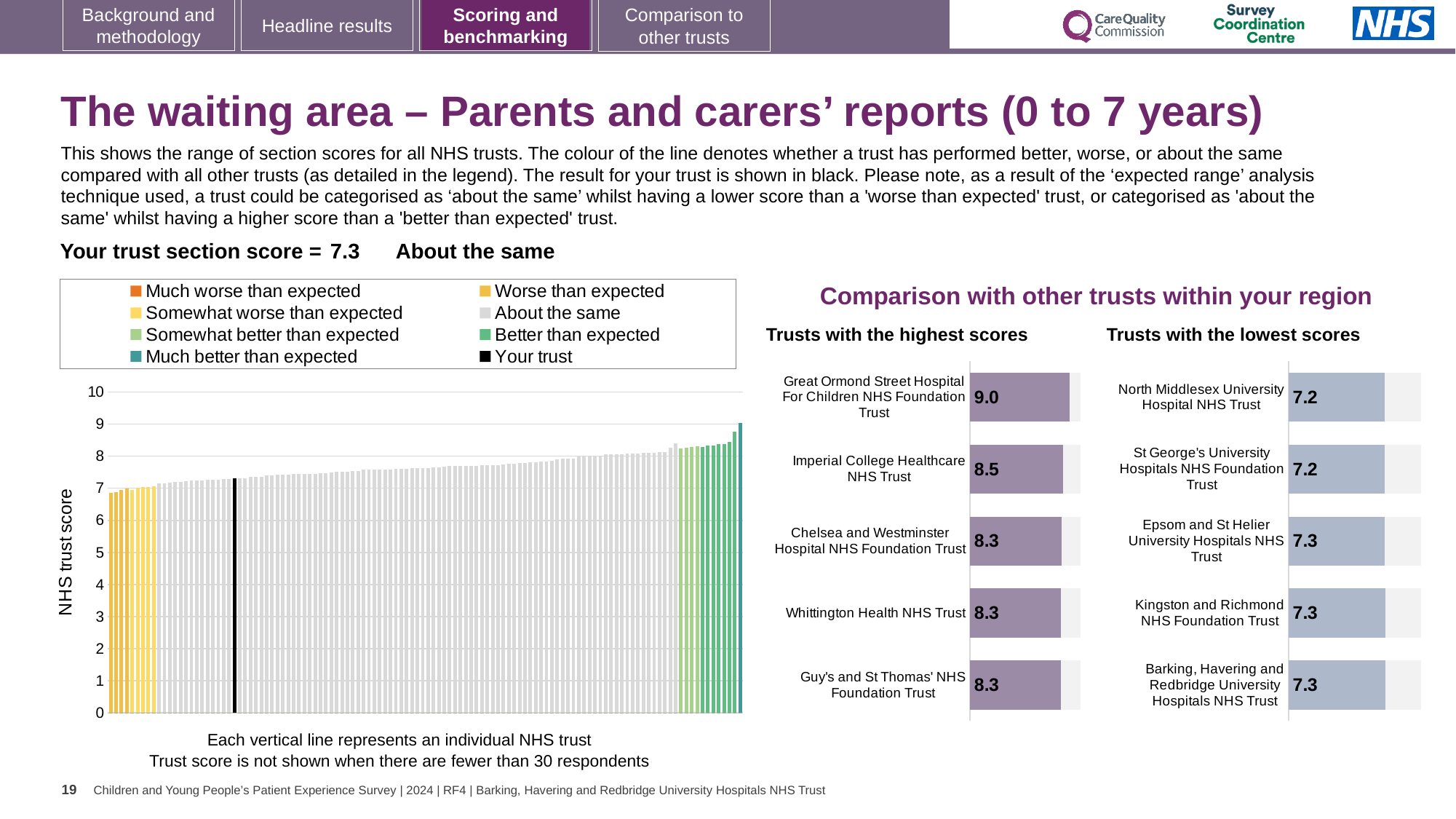
In the 'Trusts with the highest scores' chart, which trust has the highest score? Great Ormond Street Hospital For Children NHS Foundation Trust In the 'Trusts with the lowest scores' chart, how many trusts are listed? 5 In the NHS trust score chart on the left, do the bar values rise or fall from left to right? Rise How many entries does the legend of the NHS trust score chart on the left list? 8 In the 'Trusts with the highest scores' chart, what is the score for Imperial College Healthcare NHS Trust? 8.5 In the 'Trusts with the highest scores' chart, what is the score for Great Ormond Street Hospital For Children NHS Foundation Trust? 9.0 In the 'Trusts with the lowest scores' chart, what is the score for Barking, Havering and Redbridge University Hospitals NHS Trust? 7.3 In the 'Trusts with the highest scores' chart, how many trusts are shown? 5 In the 'Trusts with the lowest scores' chart, what is the score for North Middlesex University Hospital NHS Trust? 7.2 In the NHS trust score chart on the left, what kind of chart is used? Bar chart Which is larger: the score for Great Ormond Street Hospital For Children NHS Foundation Trust in the highest scores chart, or the score for North Middlesex University Hospital NHS Trust in the lowest scores chart? Great Ormond Street Hospital For Children NHS Foundation Trust In the 'Trusts with the highest scores' chart, what is the difference between the scores of Great Ormond Street Hospital For Children NHS Foundation Trust and Imperial College Healthcare NHS Trust? 0.5